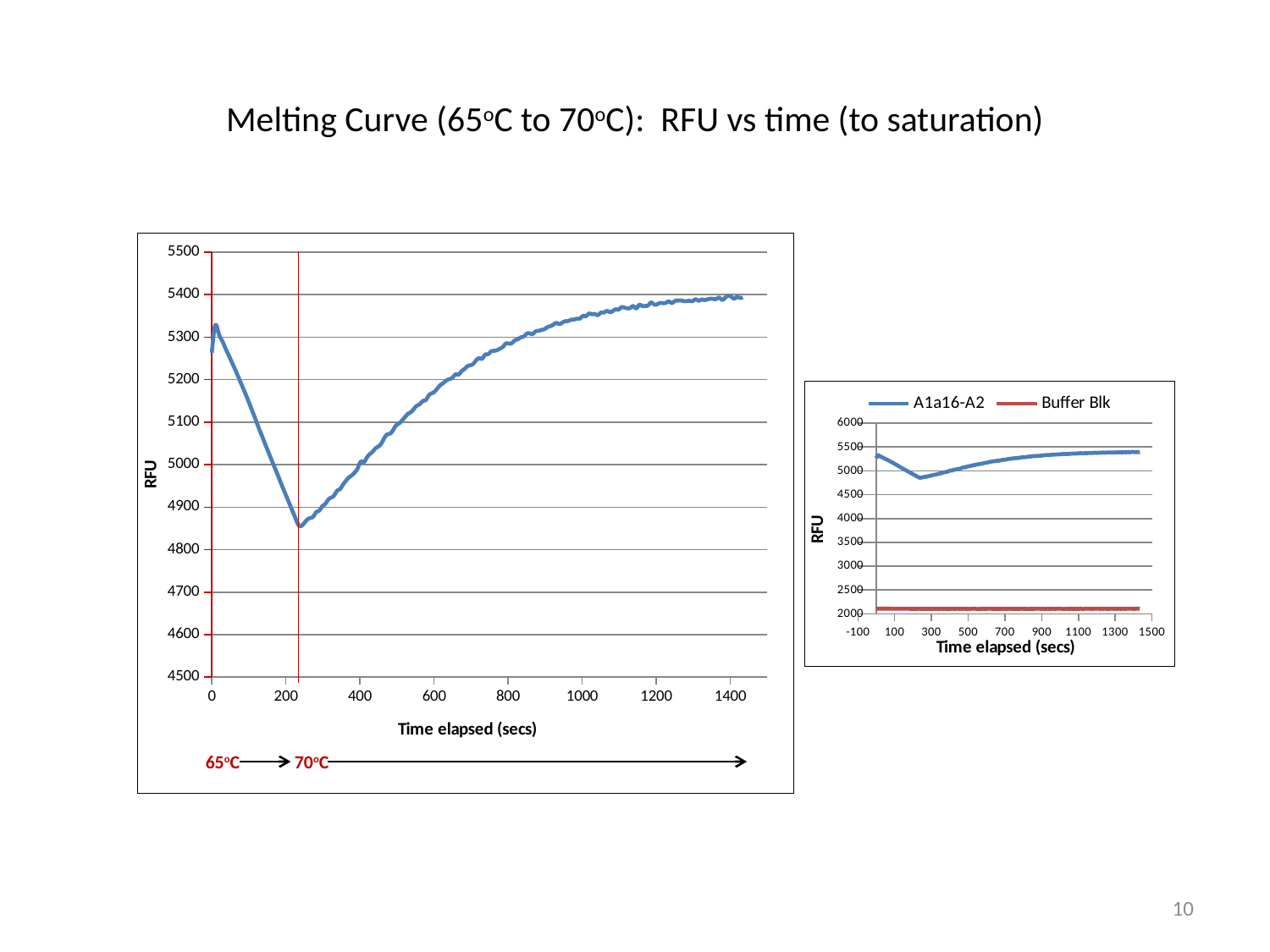
In the large chart on the left, is the RFU value at 800 seconds greater or less than 5200? greater In the large chart on the left, does the RFU value rise or fall between 400 and 1400 seconds? rise In the small chart on the right, how many series does the legend list? 2 What kind of chart is the large chart on the left of the slide? line chart In the large chart on the left, is the RFU value at 600 seconds greater or less than 5100? greater In the small chart on the right, which series has the higher RFU values, A1a16-A2 or Buffer Blk? A1a16-A2 In the large chart on the left, is the RFU value at 200 seconds greater or less than 5000? less In the large chart on the left, does the RFU value rise or fall between 0 and 200 seconds? fall In the large chart on the left, which is larger: the RFU value at 200 seconds or at 1000 seconds? 1000 seconds In the small chart on the right, what are the two legend entries? A1a16-A2 and Buffer Blk